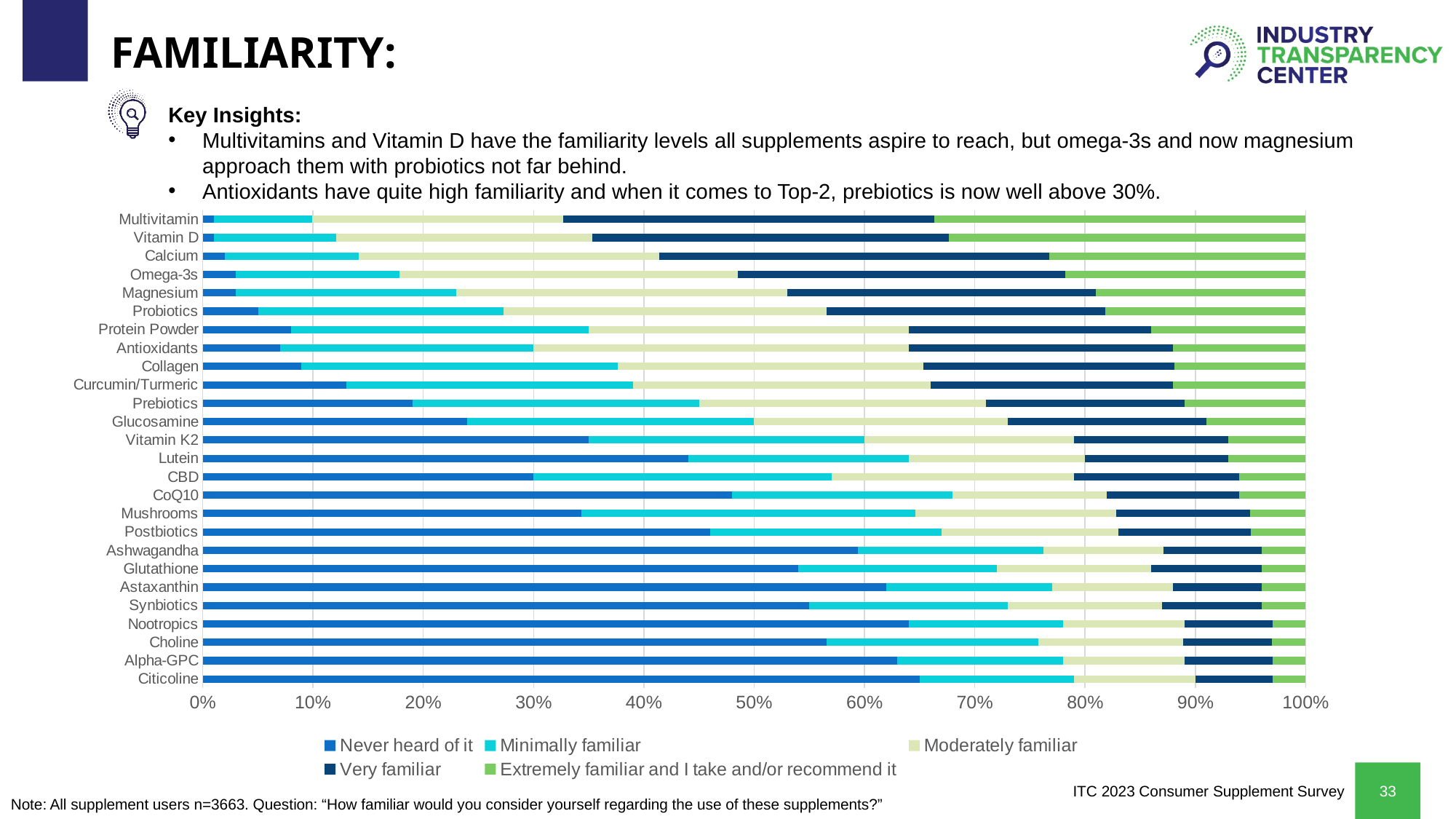
Is the 'Never heard of it' value for Glutathione greater or less than 50%? greater How many supplements are listed on the vertical axis of the chart? 26 Is the 'Never heard of it' value for Multivitamin greater or less than 10%? less Which has a larger 'Never heard of it' share, Vitamin K2 or Glucosamine? Vitamin K2 Is the 'Never heard of it' value for Citicoline greater or less than 60%? greater Going from the top supplement to the bottom supplement, does the 'Never heard of it' share generally increase or decrease? Increase Which legend entry is shown in light green? Moderately familiar What type of chart is shown on the slide? Stacked bar chart Which has a larger 'Extremely familiar and I take and/or recommend it' share, Multivitamin or Citicoline? Multivitamin Which has a larger 'Never heard of it' share, Citicoline or Multivitamin? Citicoline How many series does the chart legend list? 5